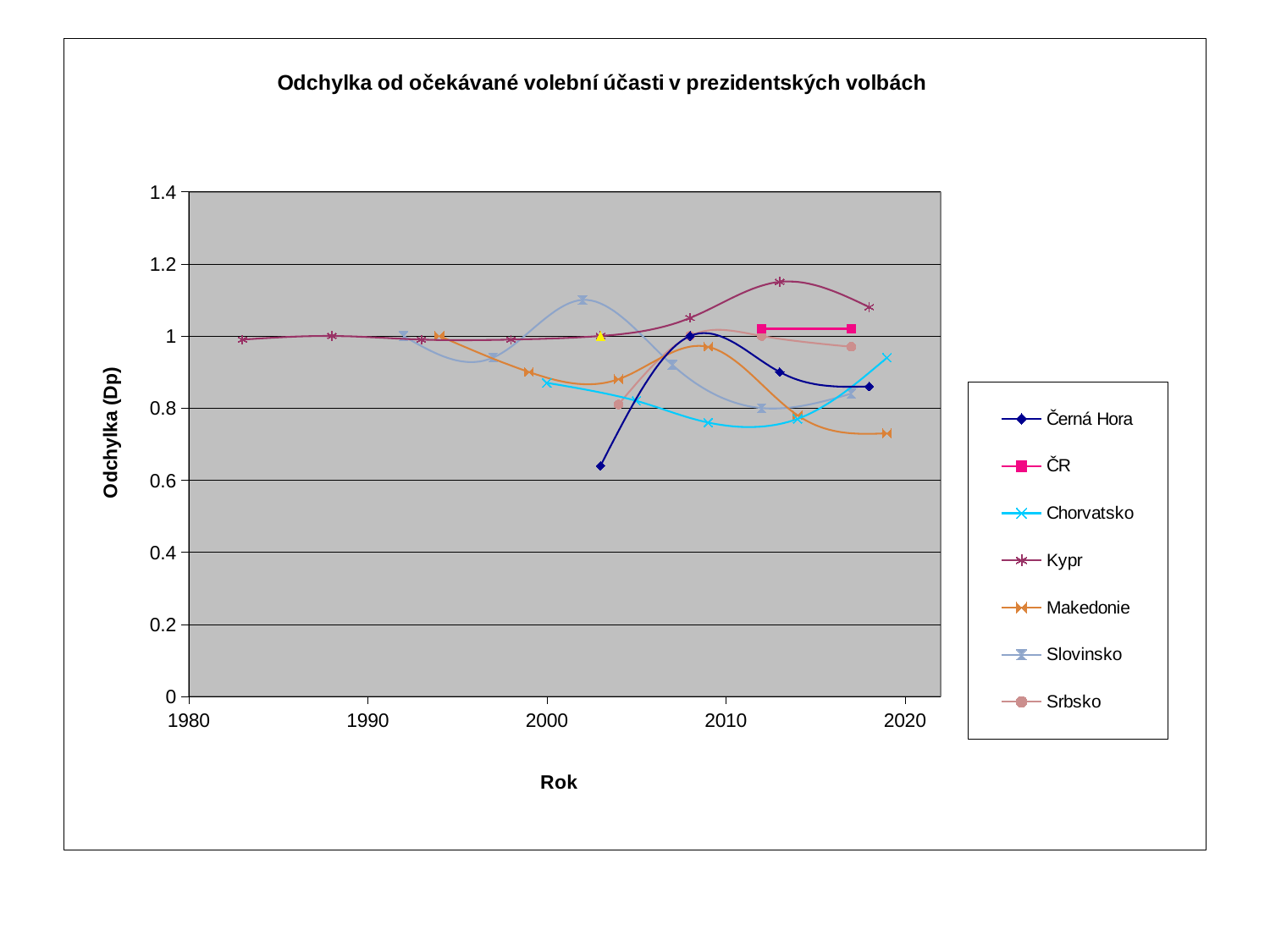
Which series has the lowest point on the chart? Černá Hora Is the value for Kypr in 2013 greater or less than 1? greater Is the value for Chorvatsko in 2009 greater or less than 0.8? less Is the value for Makedonie in 2019 greater or less than 0.8? less What kind of chart is shown on the slide? line chart How many data points are plotted for ČR? 2 What is the title of the chart? Odchylka od očekávané volební účasti v prezidentských volbách What is the label of the vertical axis? Odchylka (Dp) Which is larger: the value for Kypr in 2013 or the value for Chorvatsko in 2014? Kypr in 2013 How many series does the legend list? 7